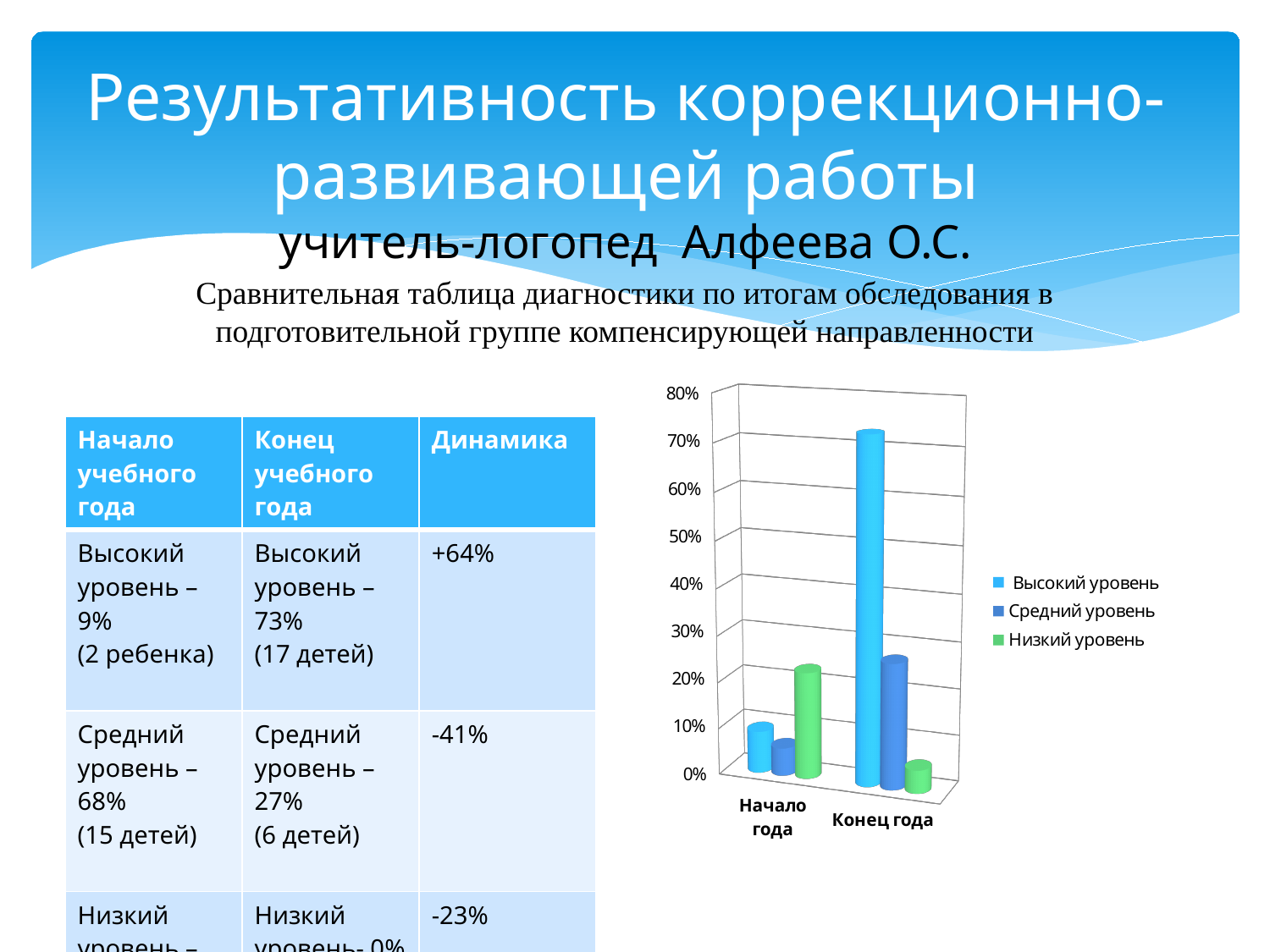
Is the value for Высокий уровень at Начало года greater or less than 20%? less Is the value for Средний уровень at Конец года greater or less than 40%? less What kind of chart is shown on the slide? bar chart Which series has the tallest bar for Конец года? Высокий уровень How many categories are shown on the x axis of the chart? 2 Which series has the shortest bar for Конец года? Низкий уровень Is the value for Высокий уровень at Конец года greater or less than 60%? greater Does the value for Низкий уровень rise or fall from Начало года to Конец года? fall For Высокий уровень, which category has the larger value: Начало года or Конец года? Конец года Which series has the tallest bar for Начало года? Низкий уровень How many series does the chart legend list? 3